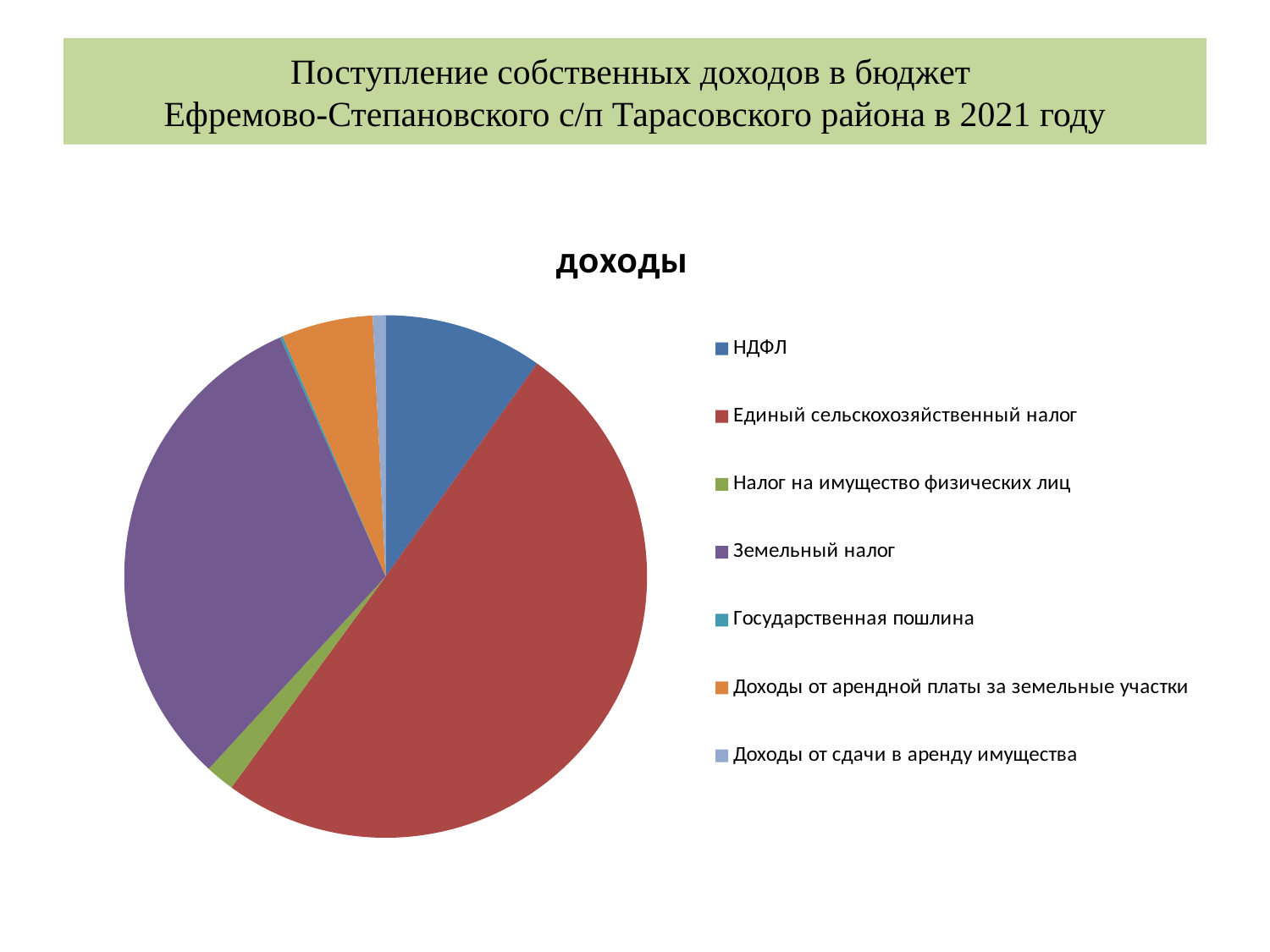
Which is larger, the slice for Единый сельскохозяйственный налог or the slice for Земельный налог? Единый сельскохозяйственный налог Which category is the second largest slice of the pie? Земельный налог What colour is the slice for Земельный налог? purple What is the title of the chart? доходы Which category has the smallest slice of the pie? Государственная пошлина Which is larger, the slice for НДФЛ or the slice for Доходы от арендной платы за земельные участки? НДФЛ What kind of chart is shown on the slide? pie chart Which is larger, the slice for Земельный налог or the slice for НДФЛ? Земельный налог How many categories does the pie chart show? 7 Which category has the largest slice of the pie? Единый сельскохозяйственный налог